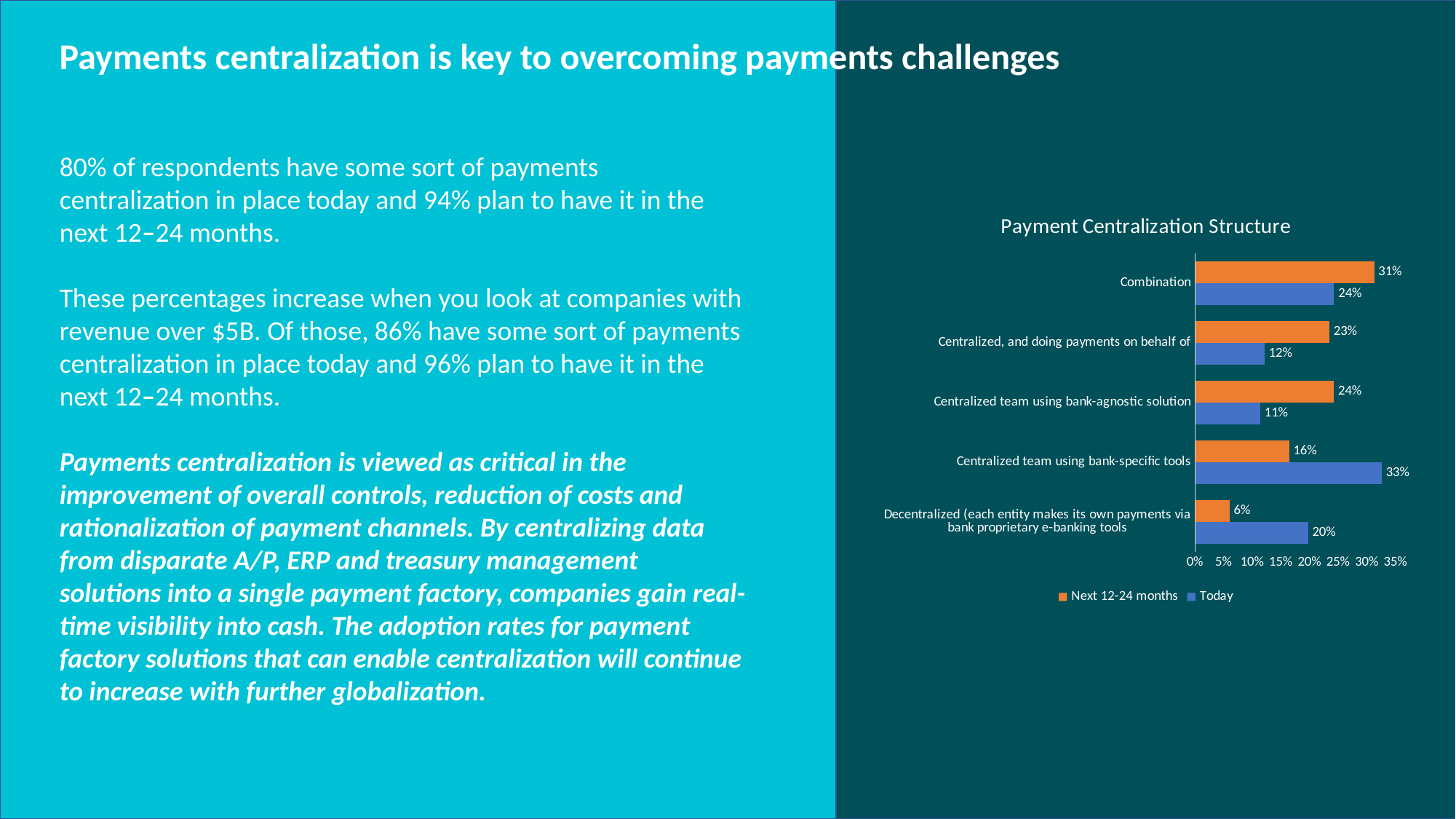
How many series does the legend list? 2 How many categories are shown in the chart? 5 Which category has the highest 'Today' value? Centralized team using bank-specific tools What is the difference between the 'Next 12-24 months' and 'Today' values for Centralized, and doing payments on behalf of? 11% What is the 'Today' value for Decentralized (each entity makes its own payments via bank proprietary e-banking tools)? 20% What is the title of the chart? Payment Centralization Structure What is the 'Today' value for Combination? 24% For Centralized team using bank-specific tools, which is larger: the 'Today' value or the 'Next 12-24 months' value? Today Which colour represents the 'Next 12-24 months' series? Orange What is the 'Next 12-24 months' value for Centralized team using bank-agnostic solution? 24% Which category has the lowest 'Next 12-24 months' value? Decentralized (each entity makes its own payments via bank proprietary e-banking tools) What kind of chart is shown on the slide? Bar chart